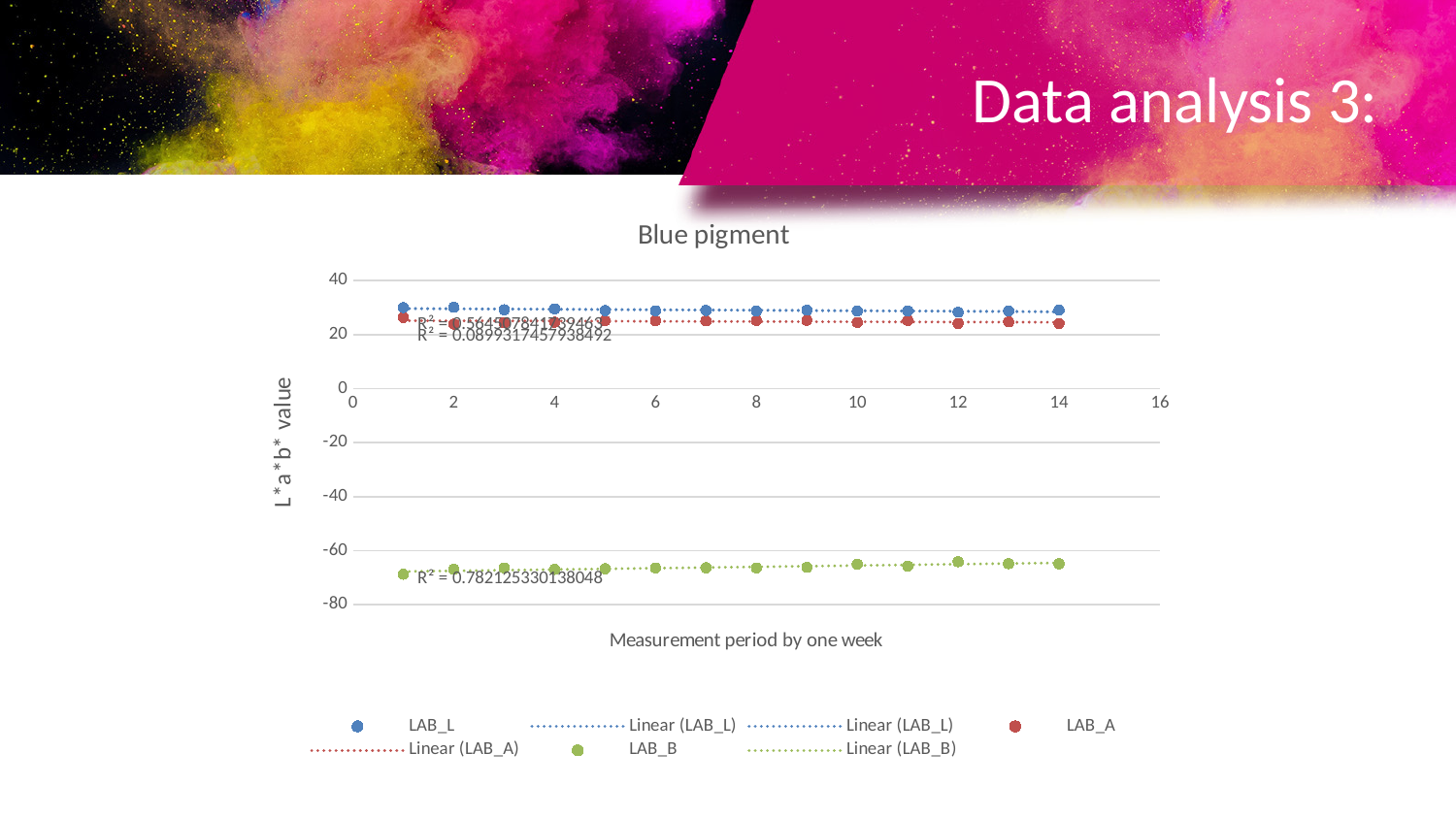
How many data points does the LAB_L series have? 14 Which series has the highest values on the chart? LAB_L How many data series (excluding trendlines) are plotted on the chart? 3 At week 14, which is larger, the LAB_L value or the LAB_A value? LAB_L Is the value for LAB_L at week 14 greater or less than 20? greater What is the label of the x axis? Measurement period by one week Which series has the lowest values on the chart? LAB_B What kind of chart is shown on the slide? Scatter chart What is the title of the chart? Blue pigment Is the value for LAB_B at week 1 greater or less than -60? less What R² value is printed for the LAB_B trendline? 0.7821253330138048 Is the value for LAB_A at week 7 greater or less than 40? less